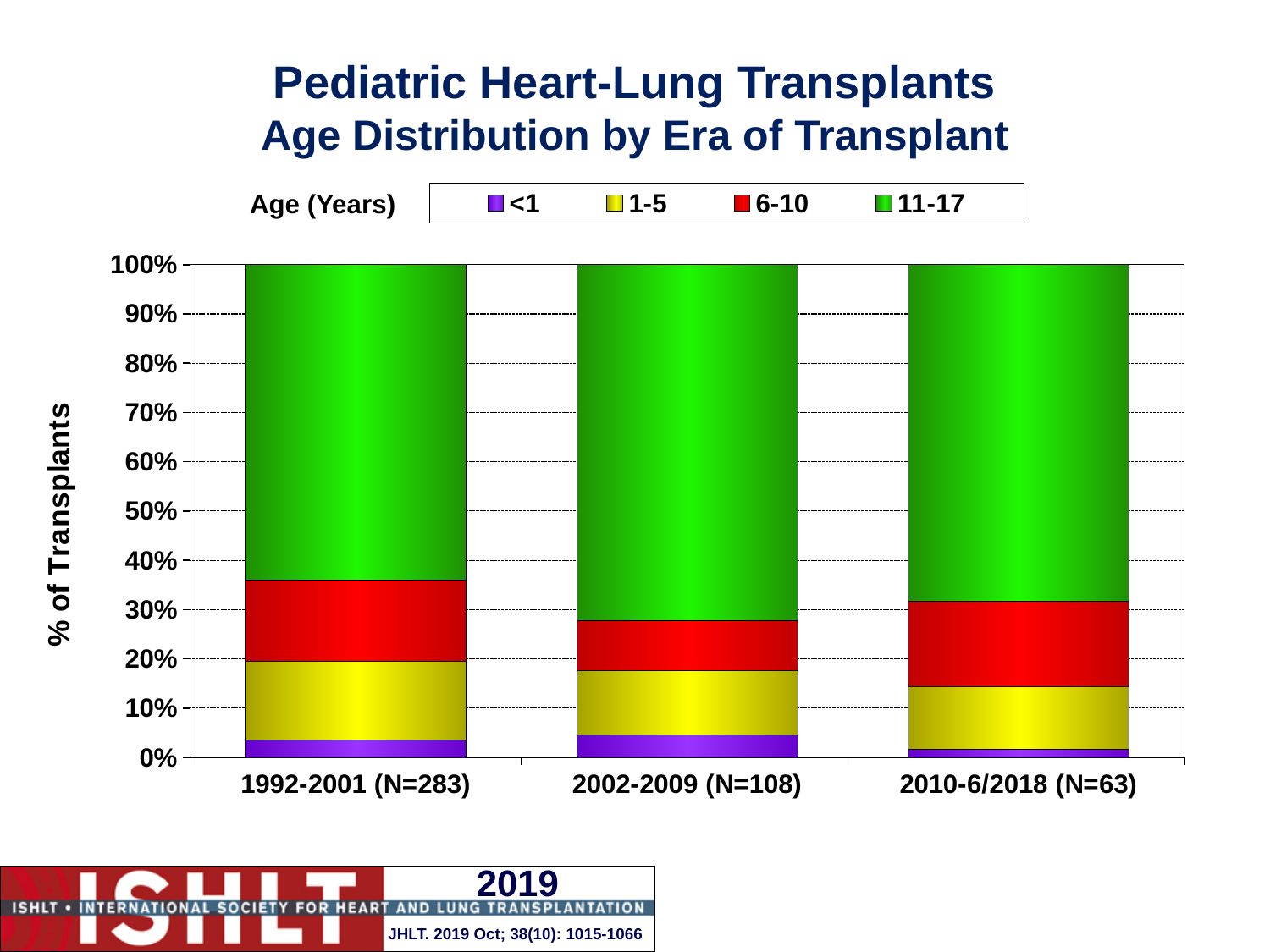
Which era has the larger share of transplants in the 1-5 age group, 1992-2001 or 2010-6/2018? 1992-2001 (N=283) Which era has the smallest share of transplants in the <1 age group? 2010-6/2018 (N=63) How many age groups does the legend list? 4 How many transplant eras are shown on the x axis? 3 Is the share of the <1 age group in the 2010-6/2018 era greater or less than 10%? less What is the N value shown for the 2002-2009 era? N=108 Is the share of the 11-17 age group in the 2002-2009 era greater or less than 60%? greater Which era has the largest share of transplants in the 11-17 age group? 2002-2009 (N=108) Is the share of the 11-17 age group in the 1992-2001 era greater or less than 60%? greater Which era has the smallest share of transplants in the 6-10 age group? 2002-2009 (N=108) What kind of chart is shown on the slide? Stacked bar chart What is the label on the y axis of the chart? % of Transplants